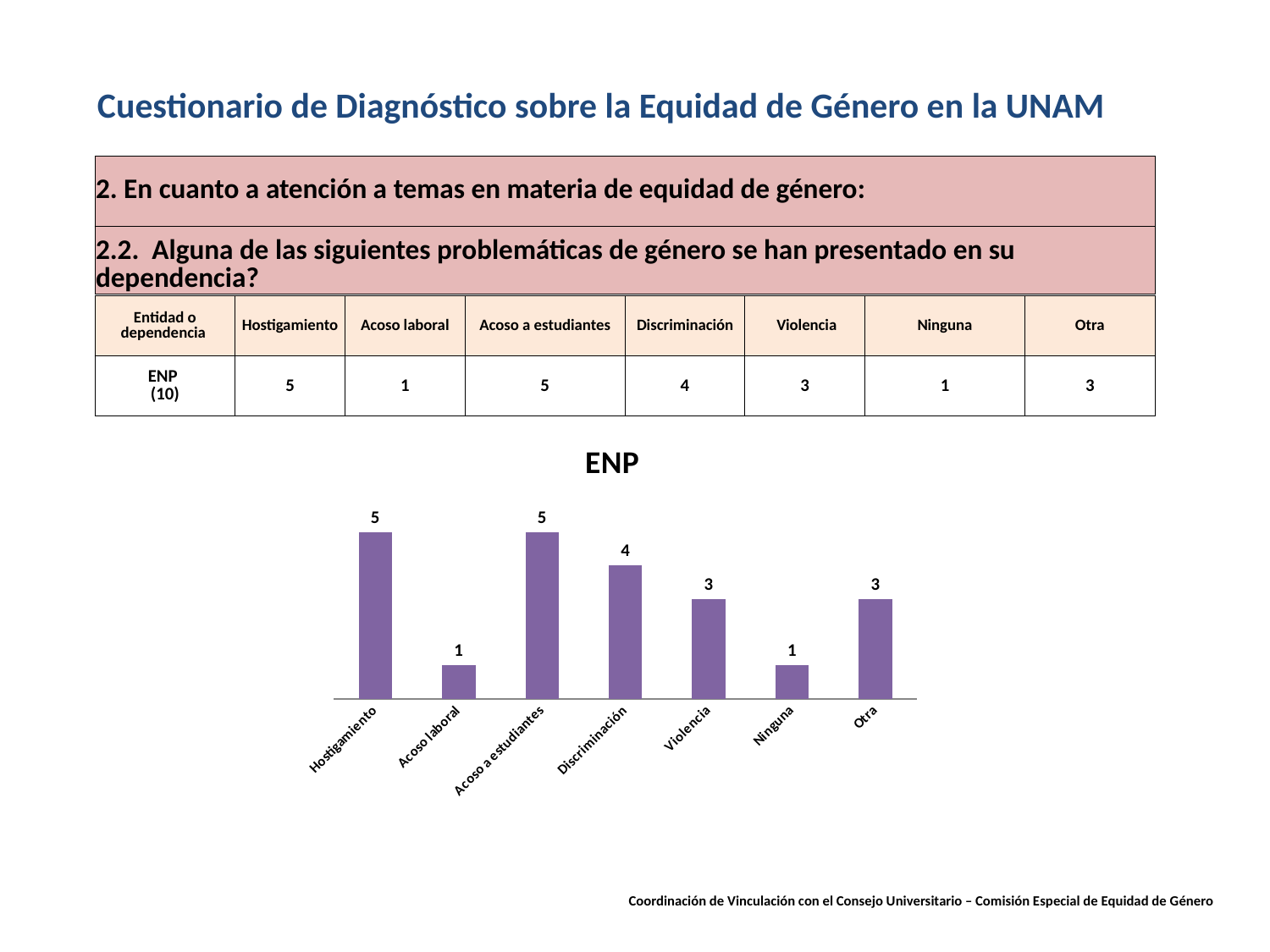
How many categories are shown in the ENP chart? 7 Which is larger in the ENP chart, Discriminación or Otra? Discriminación What colour are the bars in the ENP chart? Purple What is the title of the chart on the slide? ENP Which categories have the lowest value in the ENP chart? Acoso laboral and Ninguna What is the difference between the values for Hostigamiento and Discriminación in the ENP chart? 1 What is the value for Acoso laboral in the ENP chart? 1 What is the value for Discriminación in the ENP chart? 4 What is the difference between the values for Violencia and Ninguna in the ENP chart? 2 What is the value for Violencia in the ENP chart? 3 What kind of chart is the ENP chart? Bar chart Which categories have the highest value in the ENP chart? Hostigamiento and Acoso a estudiantes